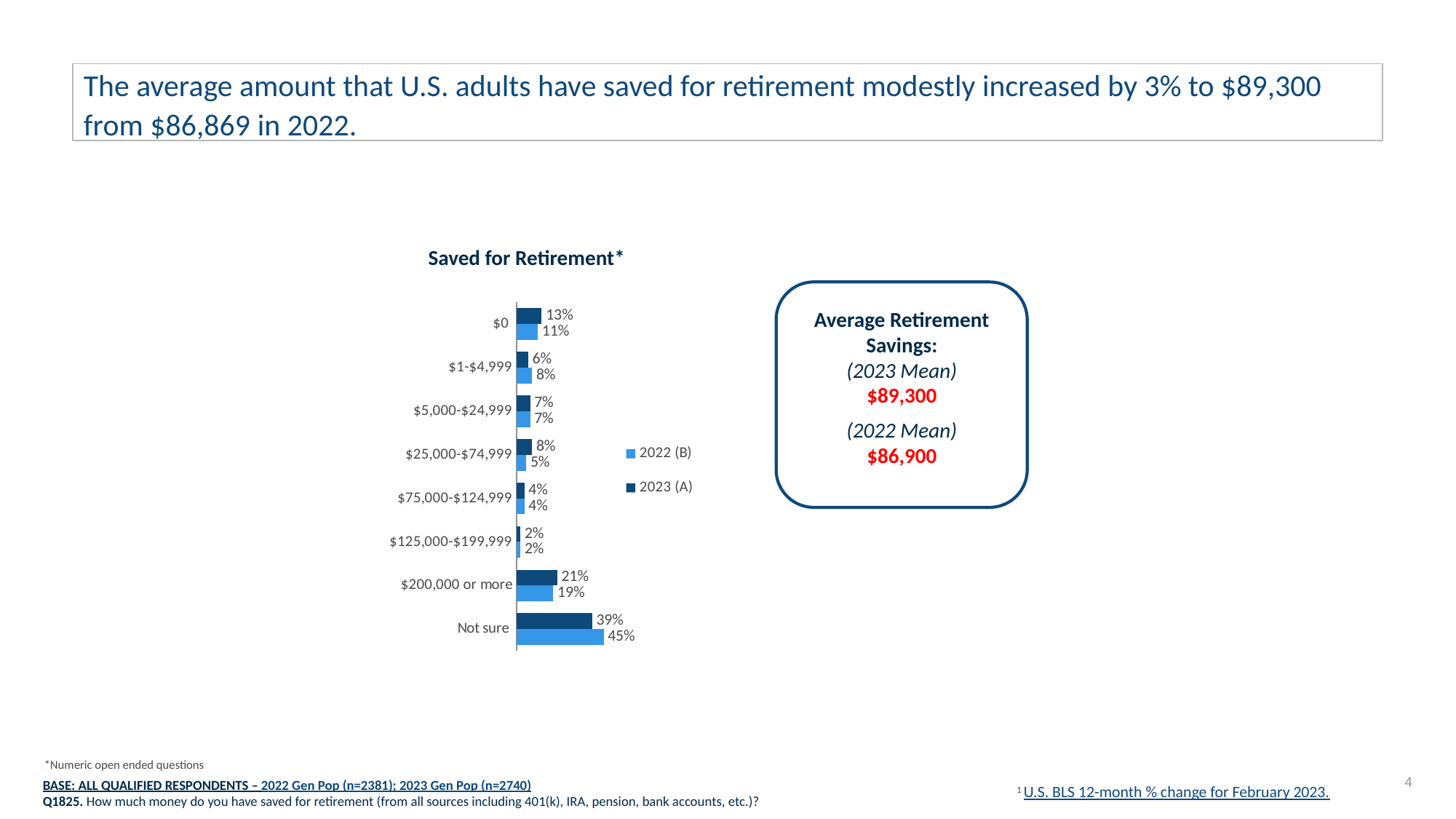
For the '$25,000-$74,999' category, which series has the larger value, 2022 (B) or 2023 (A)? 2023 (A) Which series is shown in the darker blue colour on the chart? 2023 (A) How many series does the legend of the 'Saved for Retirement' chart list? 2 What type of chart is 'Saved for Retirement'? Bar chart Which category has the lowest value for the 2022 (B) series? $125,000-$199,999 What percentage of respondents in 2022 (B) answered 'Not sure'? 45% What is the 2023 (A) value for the '$200,000 or more' category? 21% What percentage of respondents in 2023 (A) reported having $0 saved for retirement? 13% How many categories are shown on the 'Saved for Retirement' chart? 8 What is the difference between the 2022 (B) and 2023 (A) values for 'Not sure'? 6% What is the difference between the 2023 (A) and 2022 (B) values for the '$1-$4,999' category? 2% Which category has the highest value for the 2023 (A) series? Not sure